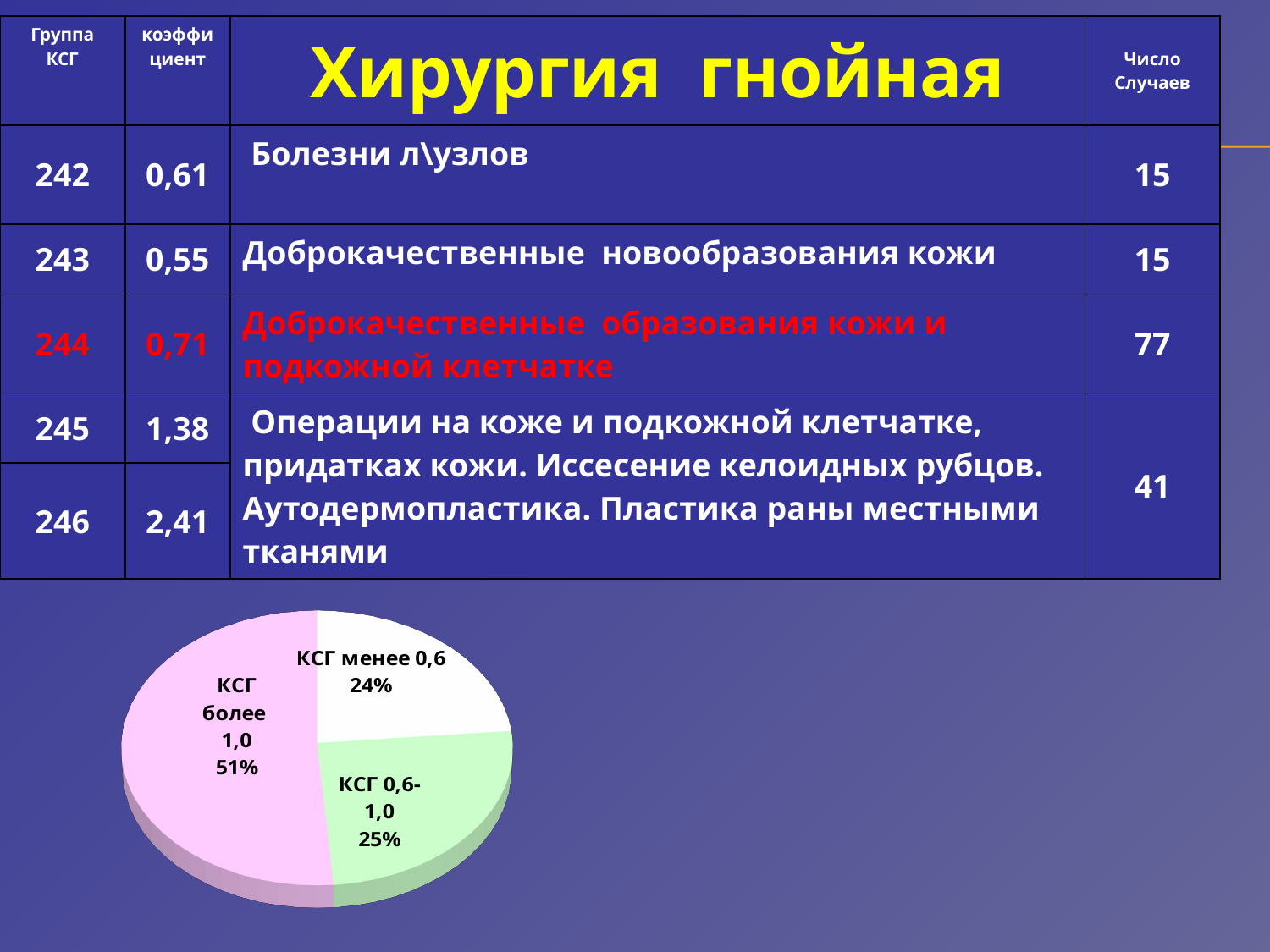
How many slices does the pie chart have? 3 Which slice of the pie chart is the largest? КСГ более 1,0 In the pie chart, what is the difference in percentage points between "КСГ более 1,0" and "КСГ 0,6-1,0"? 26 What share of the pie chart is labelled "КСГ более 1,0"? 51% Which slice of the pie chart is the smallest? КСГ менее 0,6 In the pie chart, which is larger: "КСГ более 1,0" or "КСГ менее 0,6"? КСГ более 1,0 In the pie chart, what is the difference in percentage points between "КСГ 0,6-1,0" and "КСГ менее 0,6"? 1 What share of the pie chart is labelled "КСГ 0,6-1,0"? 25% What colour is the "КСГ более 1,0" slice of the pie chart? pink What share of the pie chart is labelled "КСГ менее 0,6"? 24% What kind of chart is shown at the bottom of the slide? pie chart What colour is the "КСГ 0,6-1,0" slice of the pie chart? light green